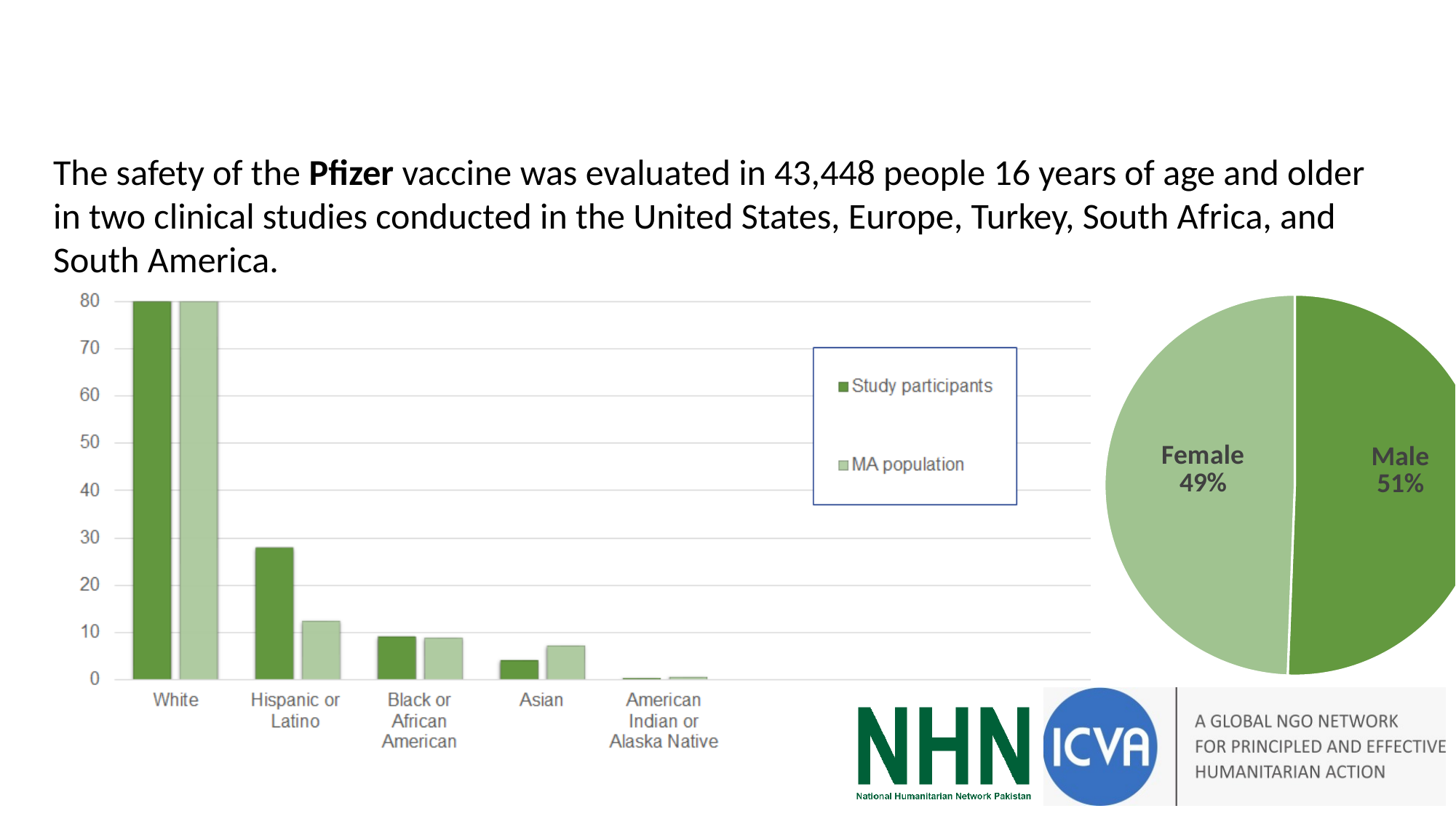
In the bar chart on the left, is the Study participants value for Hispanic or Latino greater or less than 20? greater In the pie chart on the right, which slice is larger, Female or Male? Male In the bar chart on the left, how many series does the legend list? 2 In the bar chart on the left, which category has the lowest MA population value? American Indian or Alaska Native What kind of chart is the chart on the right of the slide? pie chart In the bar chart on the left, how many categories are shown on the x axis? 5 In the pie chart on the right, what share is Male? 51% In the bar chart on the left, which category has the highest Study participants value? White In the bar chart on the left, for Asian, which series has the larger value: Study participants or MA population? MA population In the bar chart on the left, is the MA population value for Hispanic or Latino greater or less than 20? less What kind of chart is the chart on the left of the slide? bar chart In the bar chart on the left, what are the two series named in the legend? Study participants and MA population